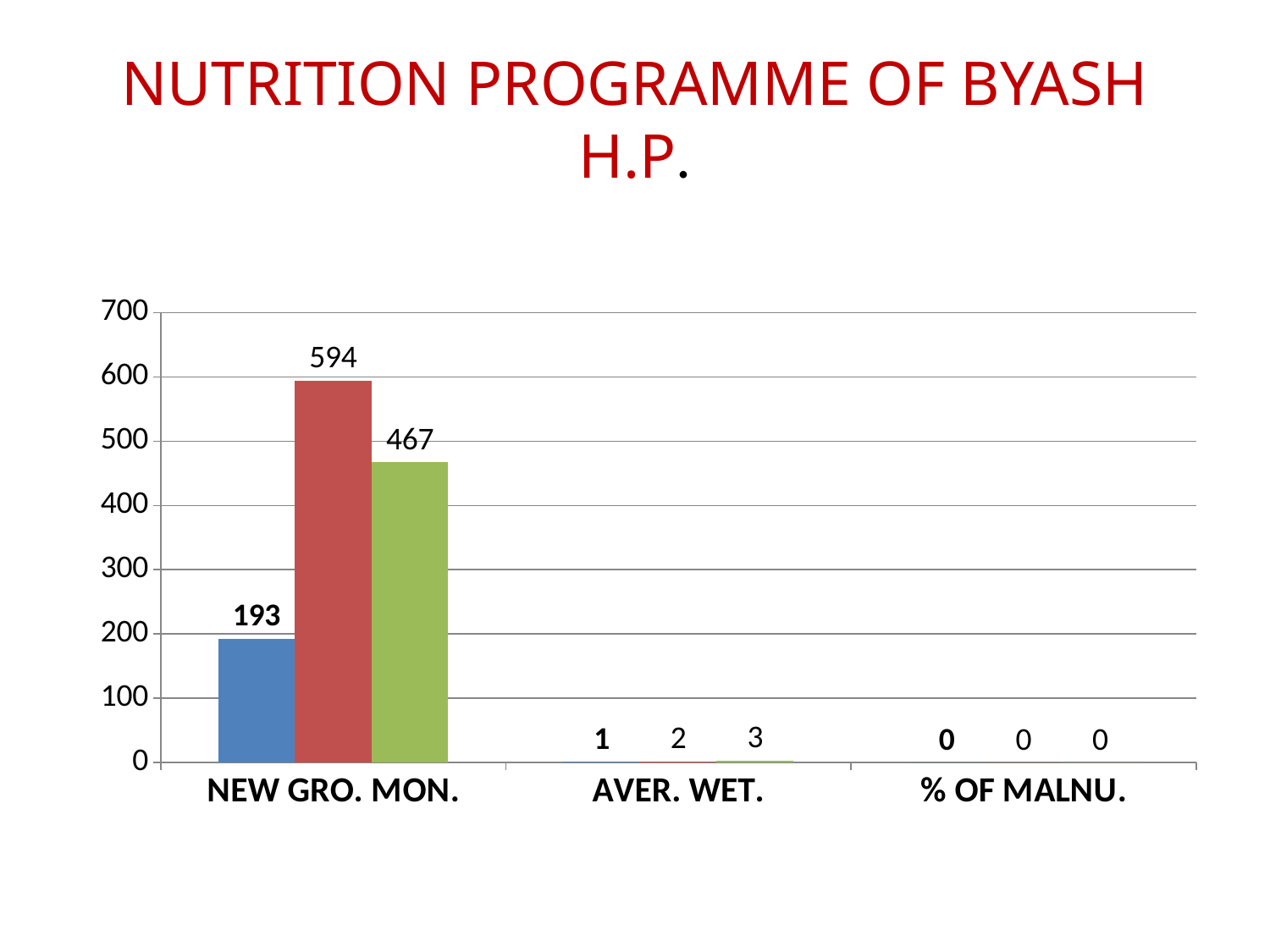
Which colour bar is lowest for NEW GRO. MON.? blue Which colour bar is highest for NEW GRO. MON.? red What kind of chart is shown on the slide? bar chart What is the difference between the red and green bars for NEW GRO. MON.? 127 What is the value of the blue bar for % OF MALNU.? 0 What is the value of the blue bar for NEW GRO. MON.? 193 How many categories are shown on the x axis? 3 Which is larger for NEW GRO. MON., the blue bar or the green bar? green bar What is the value of the red bar for NEW GRO. MON.? 594 What is the value of the green bar for AVER. WET.? 3 What is the value of the green bar for NEW GRO. MON.? 467 What is the title of the slide? NUTRITION PROGRAMME OF BYASH H.P.